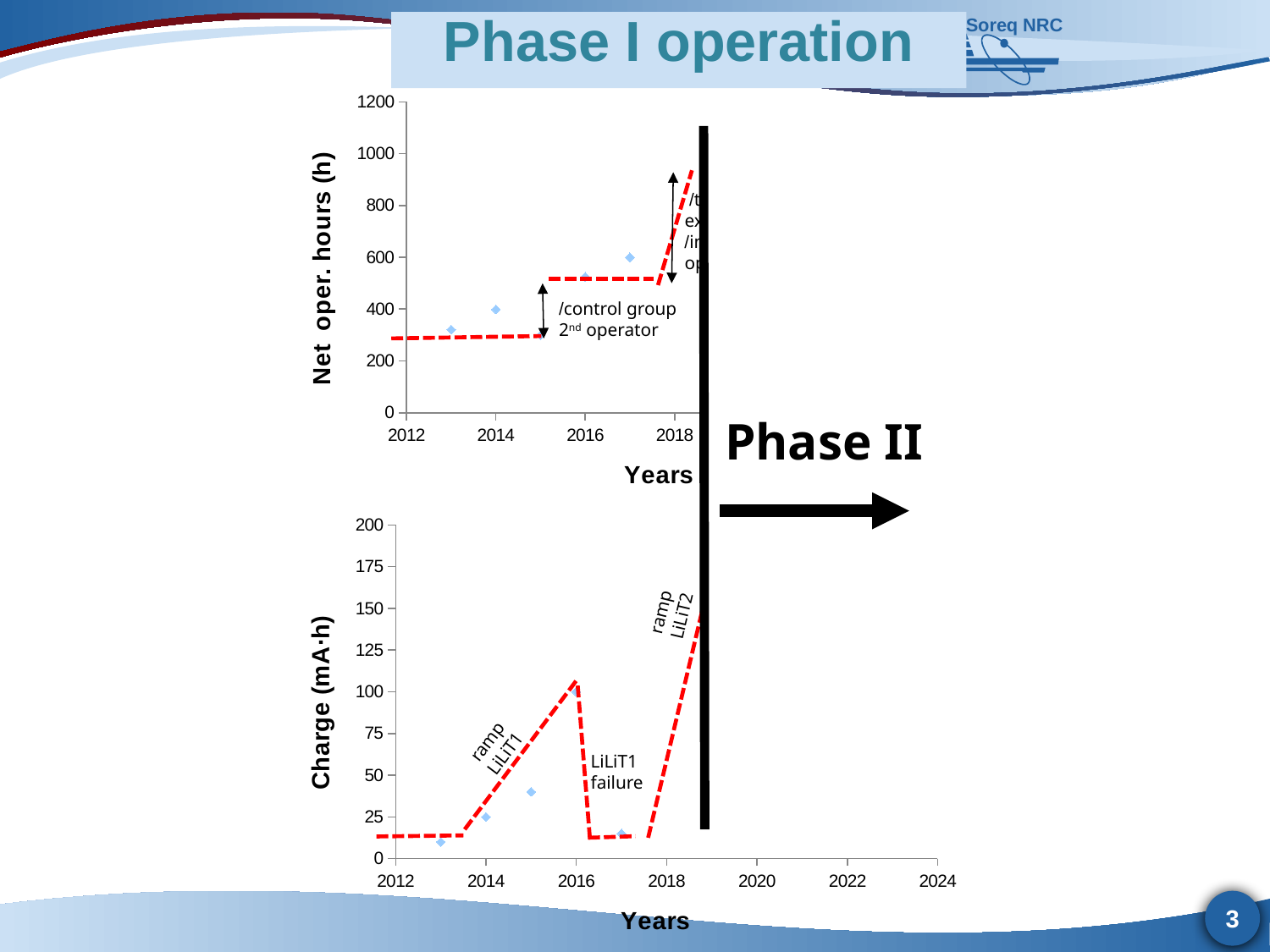
In the bottom chart (Charge), which is larger, the value for 2015 or the value for 2017? 2015 In the bottom chart (Charge), how many data points are plotted? 5 In the top chart (Net oper. hours), what is the maximum value shown on the vertical axis? 1200 In the top chart (Net oper. hours), which plotted year has the highest value? 2017 In the bottom chart (Charge), is the value for 2017 greater or less than 50? less In the top chart (Net oper. hours), is the value for 2013 greater or less than 400? less In the bottom chart (Charge), is the value for 2016 greater or less than 75? greater What is the label of the vertical axis of the bottom chart? Charge (mA·h) In the top chart (Net oper. hours), do the plotted values rise or fall from 2013 to 2017? rise In the bottom chart (Charge), which plotted year has the highest value? 2016